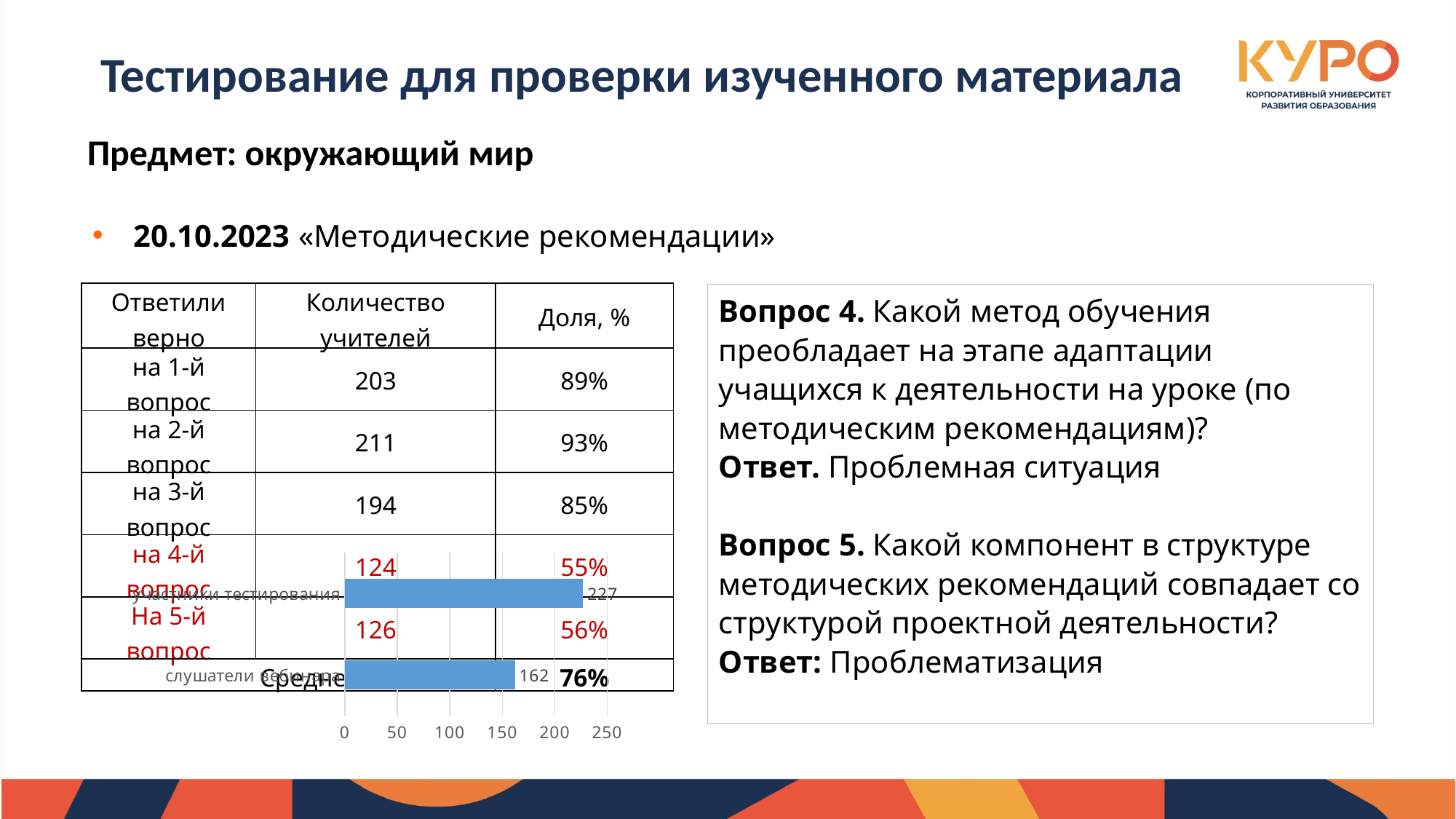
How many categories (bars) are shown in the bar chart? 2 What type of chart is shown on the slide? bar chart Which category has the highest value in the bar chart? участники тестирования Is the value for слушатели вебинара greater or less than 200? less What is the value for участники тестирования in the bar chart? 227 Which is larger: the value for участники тестирования or for слушатели вебинара? участники тестирования What is the maximum value shown on the x axis of the bar chart? 250 What colour are the bars in the chart? blue What is the difference between the values for участники тестирования and слушатели вебинара? 65 What is the value for слушатели вебинара in the bar chart? 162 Which category has the lowest value in the bar chart? слушатели вебинара Is the value for участники тестирования greater or less than 200? greater